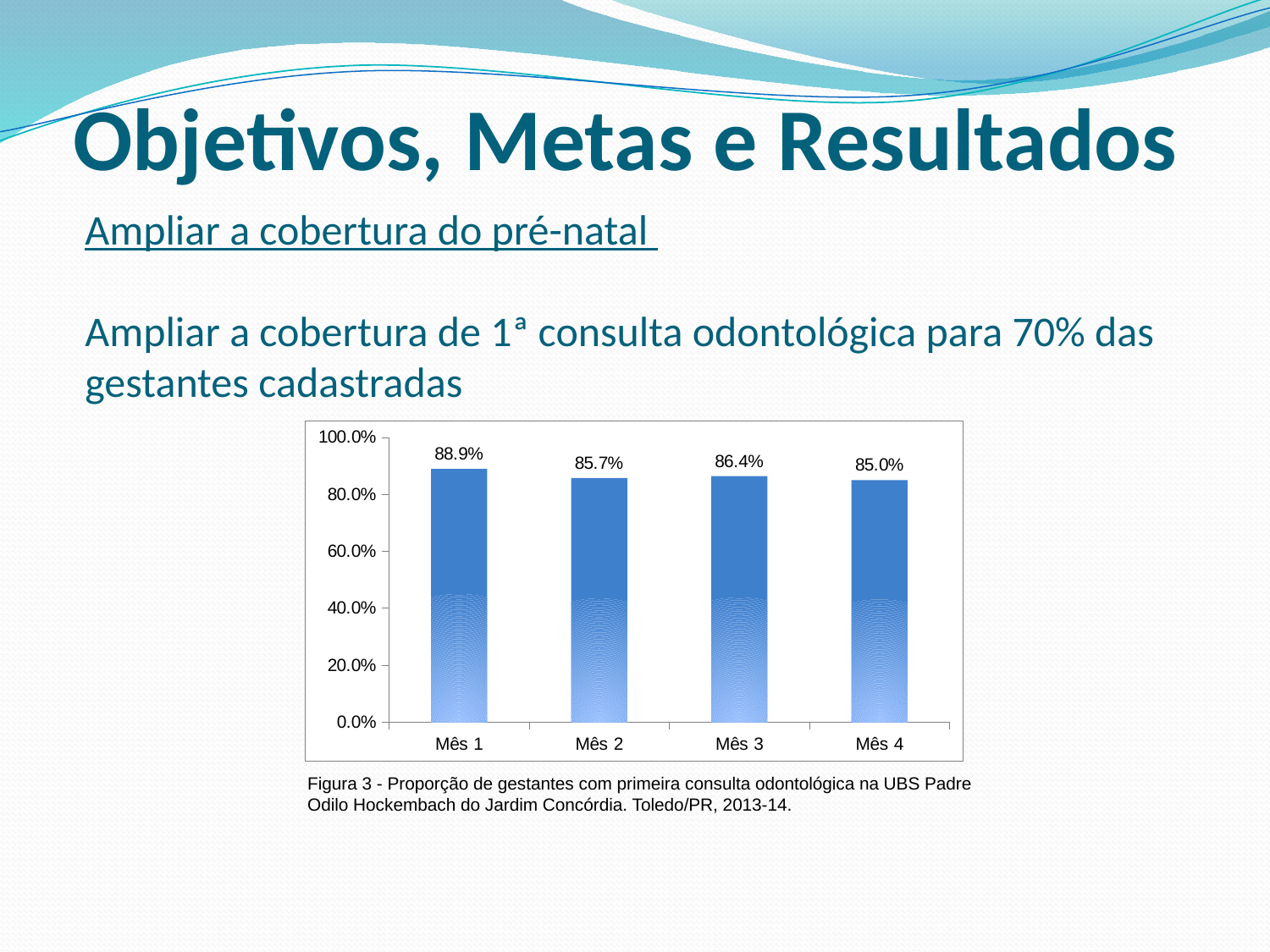
How many months are shown on the x axis? 4 What is the value for Mês 1? 88.9% What is the difference between the values for Mês 3 and Mês 2? 0.7% Which month has the highest value? Mês 1 What is the value for Mês 2? 85.7% What is the value for Mês 4? 85.0% Which month has the lowest value? Mês 4 What is the difference between the values for Mês 1 and Mês 4? 3.9% What kind of chart is shown on the slide? bar chart Which is larger, the value for Mês 1 or the value for Mês 3? Mês 1 What is the value for Mês 3? 86.4% Is the value for Mês 2 greater or less than 80.0%? greater